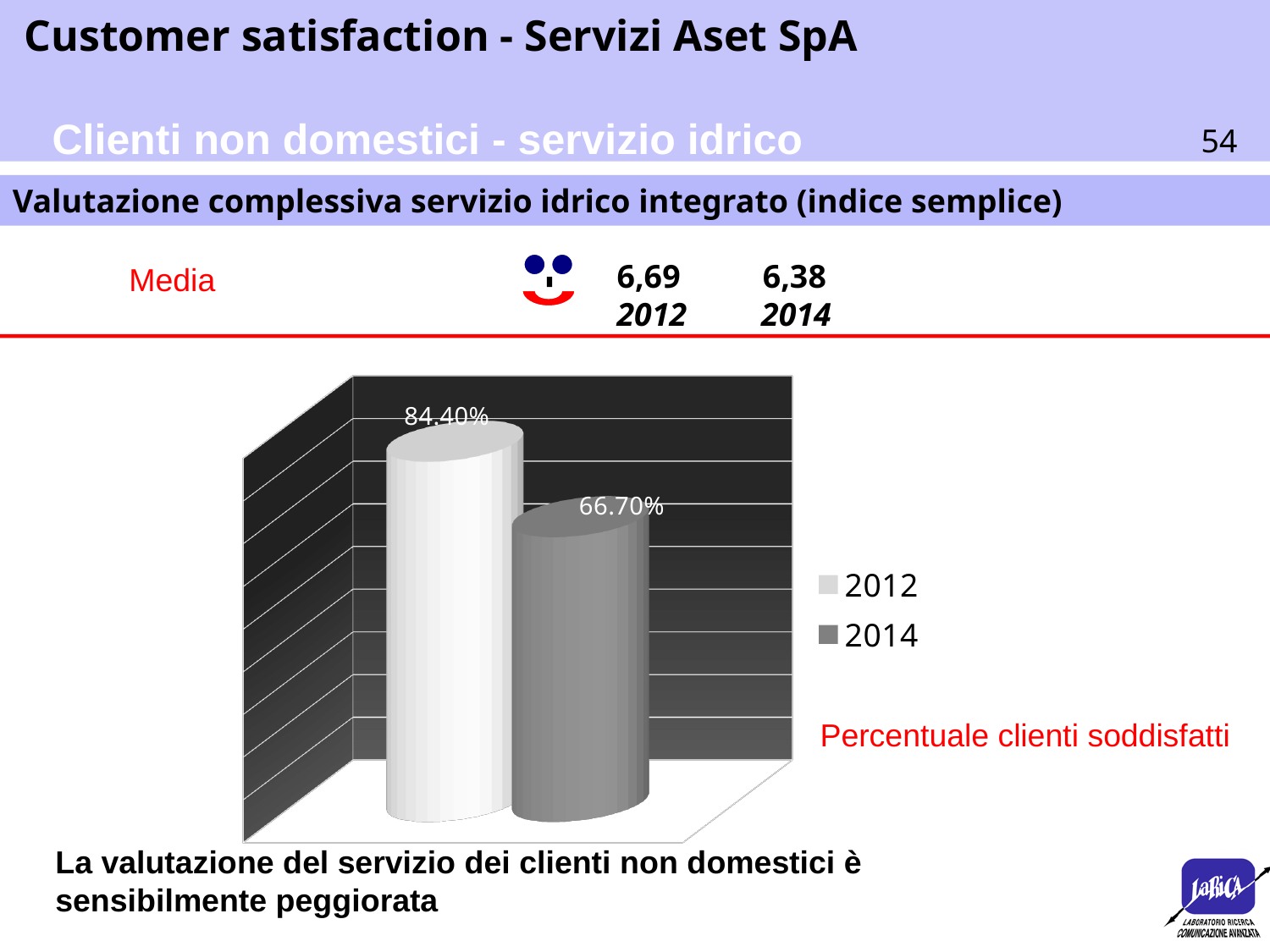
Which year has the lower value in the chart? 2014 How many bars are plotted in the chart? 2 What kind of chart is shown on the slide? bar chart Do the values rise or fall from 2012 to 2014? fall What is the difference between the 2012 value and the 2014 value in the chart? 17.70% What is the value shown for 2012 in the chart? 84.40% What is the value shown for 2014 in the chart? 66.70% What does the red text next to the chart say the chart shows? Percentuale clienti soddisfatti Is the value for 2014 larger or smaller than the value for 2012? smaller How many series does the chart legend list? 2 Which series is drawn in the darker grey colour in the chart? 2014 Which year has the higher value in the chart? 2012